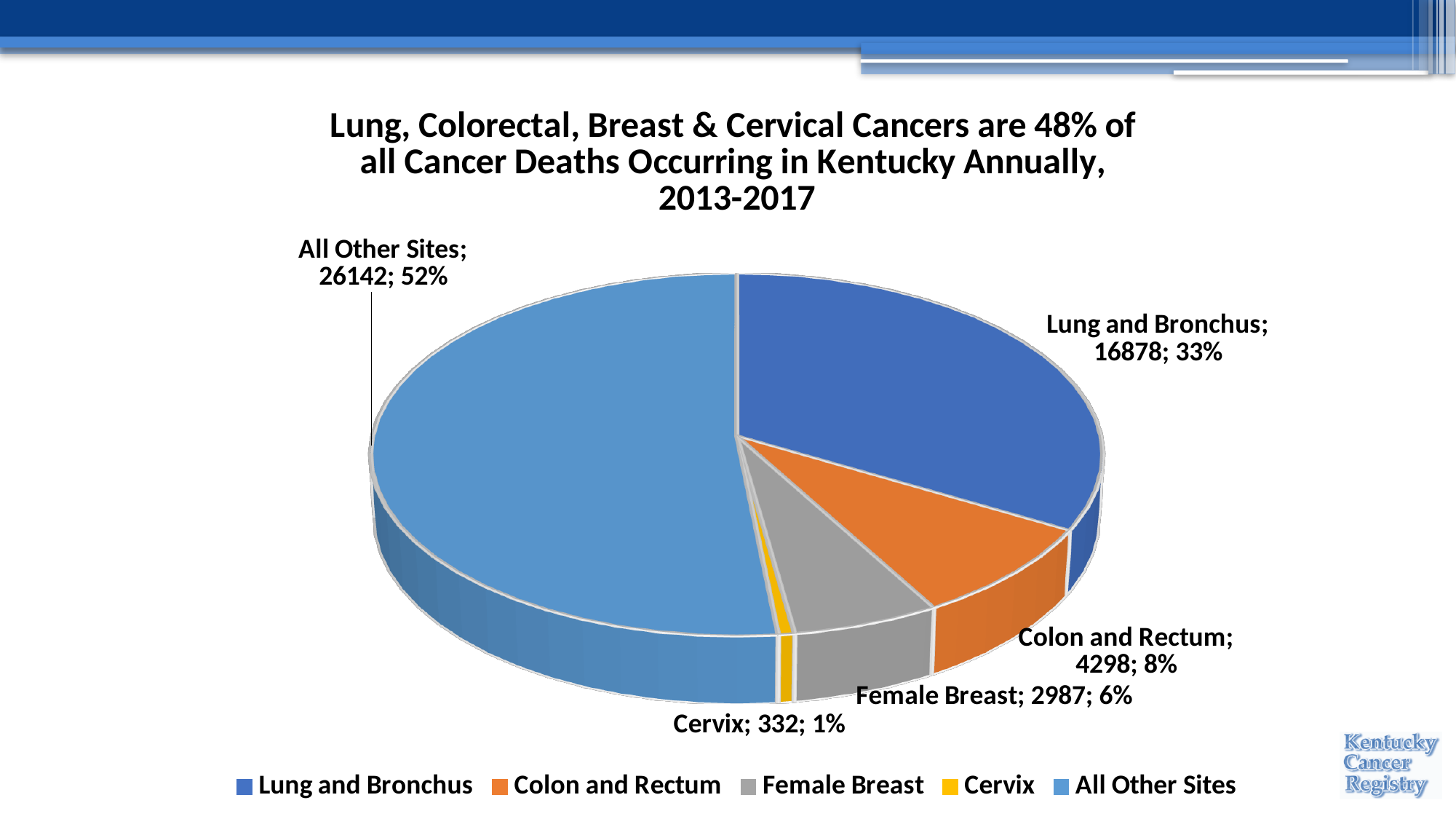
How many deaths are shown for Colon and Rectum? 4298 What percentage share does Female Breast have? 6% How many categories does the pie chart show? 5 What colour is the Cervix slice? Yellow How many deaths are shown for Cervix? 332 What is the difference in deaths between Lung and Bronchus and Colon and Rectum? 12580 Which category has the smallest slice? Cervix Which category has the largest slice? All Other Sites What percentage share does All Other Sites have? 52% Which has more deaths, Female Breast or Colon and Rectum? Colon and Rectum How many deaths are shown for Lung and Bronchus? 16878 What type of chart is shown on the slide? Pie chart